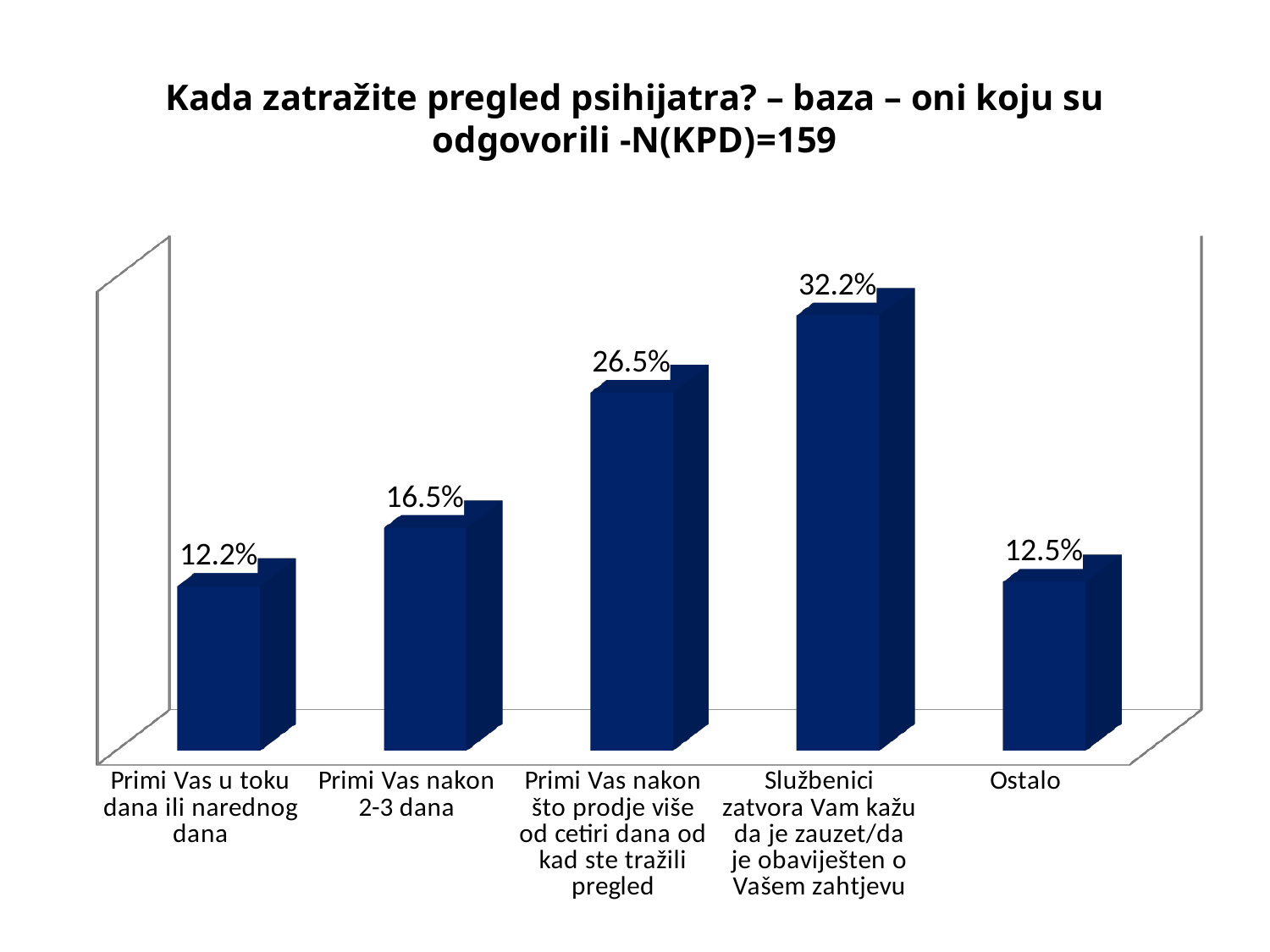
What is the value for "Primi Vas u toku dana ili narednog dana"? 12.2% What kind of chart is shown on the slide? Bar chart How many categories are shown in the chart? 5 Which is larger, the value for "Primi Vas nakon 2-3 dana" or the value for "Ostalo"? Primi Vas nakon 2-3 dana What is the difference between the values for "Primi Vas nakon 2-3 dana" and "Primi Vas u toku dana ili narednog dana"? 4.3% What is the value for "Primi Vas nakon 2-3 dana"? 16.5% Which category has the highest value? Službenici zatvora Vam kažu da je zauzet/da je obaviješten o Vašem zahtjevu Which category has the lowest value? Primi Vas u toku dana ili narednog dana What is the title of the chart? Kada zatražite pregled psihijatra? – baza – oni koju su odgovorili -N(KPD)=159 What is the value for "Službenici zatvora Vam kažu da je zauzet/da je obaviješten o Vašem zahtjevu"? 32.2% What is the value for "Ostalo"? 12.5% What is the difference between the values for "Službenici zatvora Vam kažu da je zauzet/da je obaviješten o Vašem zahtjevu" and "Primi Vas nakon što prodje više od cetiri dana od kad ste tražili pregled"? 5.7%